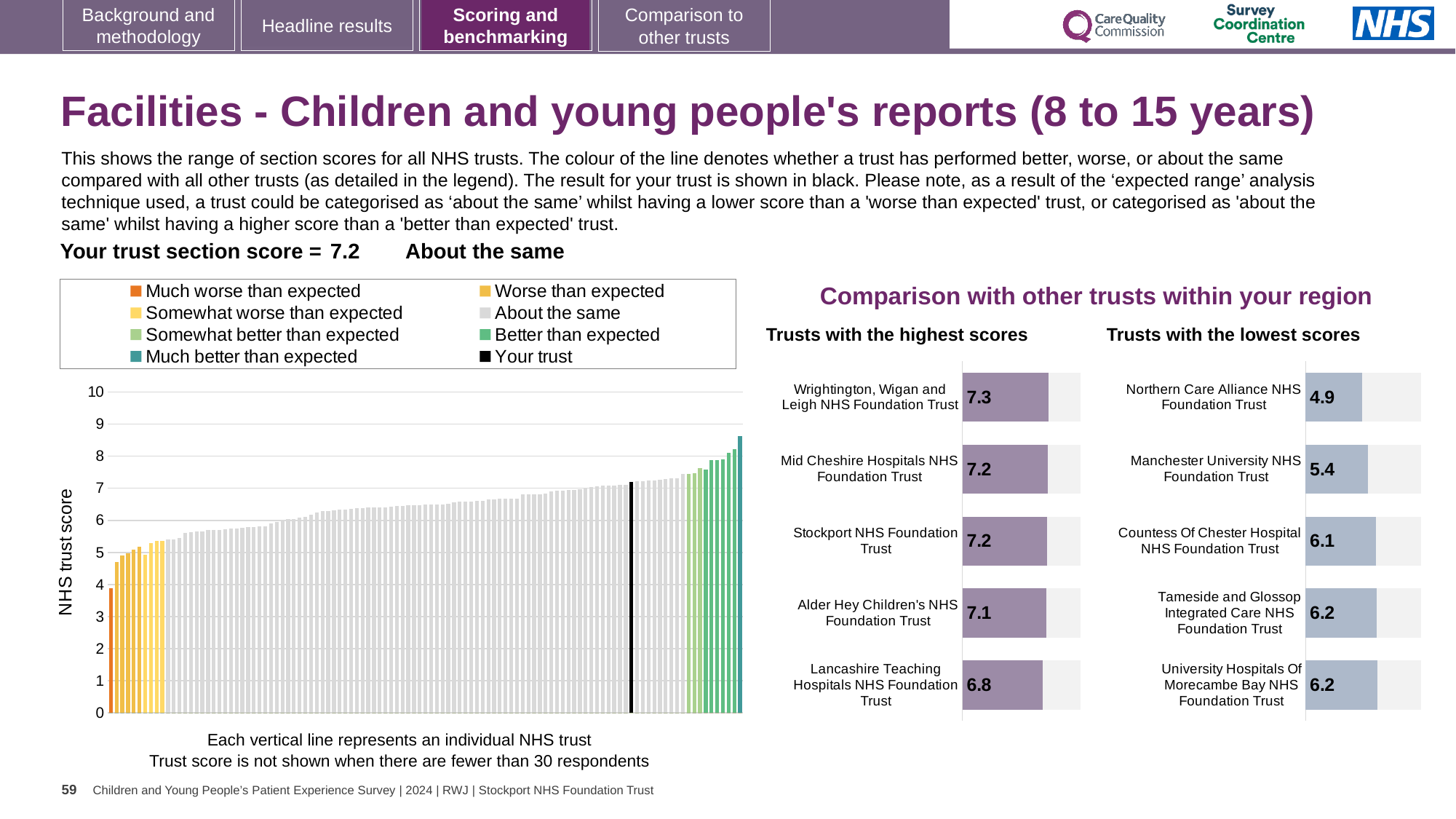
In the main chart on the left, do the trust scores rise or fall from left to right? Rise In the 'Trusts with the lowest scores' chart, which trust has the lowest score? Northern Care Alliance NHS Foundation Trust In the main chart on the left, is the value of the black bar (your trust) greater or less than 7? greater In the 'Trusts with the lowest scores' chart, which has the higher score: Countess Of Chester Hospital NHS Foundation Trust or Manchester University NHS Foundation Trust? Countess Of Chester Hospital NHS Foundation Trust In the 'Trusts with the highest scores' chart, what is the score for Wrightington, Wigan and Leigh NHS Foundation Trust? 7.3 In the 'Trusts with the highest scores' chart, what is the difference between the scores of Wrightington, Wigan and Leigh NHS Foundation Trust and Lancashire Teaching Hospitals NHS Foundation Trust? 0.5 In the 'Trusts with the lowest scores' chart, what is the difference between the scores of Manchester University NHS Foundation Trust and Northern Care Alliance NHS Foundation Trust? 0.5 How many trusts are listed in the 'Trusts with the highest scores' chart? 5 In the 'Trusts with the highest scores' chart, which trust has the lowest score? Lancashire Teaching Hospitals NHS Foundation Trust In the 'Trusts with the lowest scores' chart, what is the score for Northern Care Alliance NHS Foundation Trust? 4.9 In the main chart on the left, how many entries does the legend list? 8 What kind of chart is the main chart on the left showing NHS trust scores? Bar chart